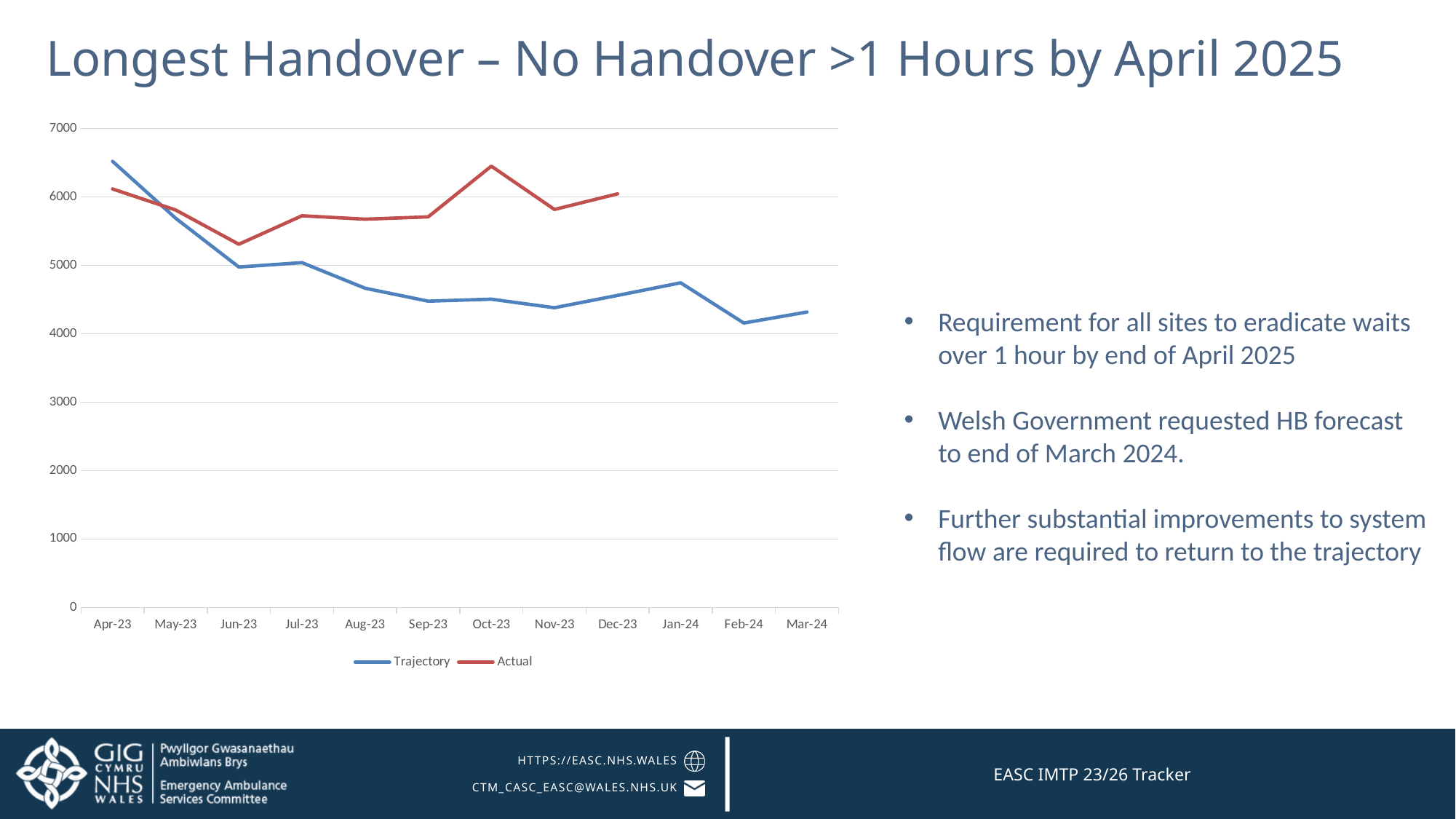
How many months are shown on the x axis of the chart? 12 Is the Trajectory value for Apr-23 greater or less than 6000? greater Is the Actual value for Oct-23 greater or less than 6000? greater Is the Actual value for Jun-23 greater or less than 6000? less What kind of chart is shown on the slide? Line chart How many series does the chart legend list? 2 In Dec-23, which series has the higher value, Trajectory or Actual? Actual In which month does the Trajectory series reach its highest value? Apr-23 What are the two series named in the chart legend? Trajectory and Actual In which month does the Actual series reach its lowest value? Jun-23 Which month is the last one with a plotted value for the Actual series? Dec-23